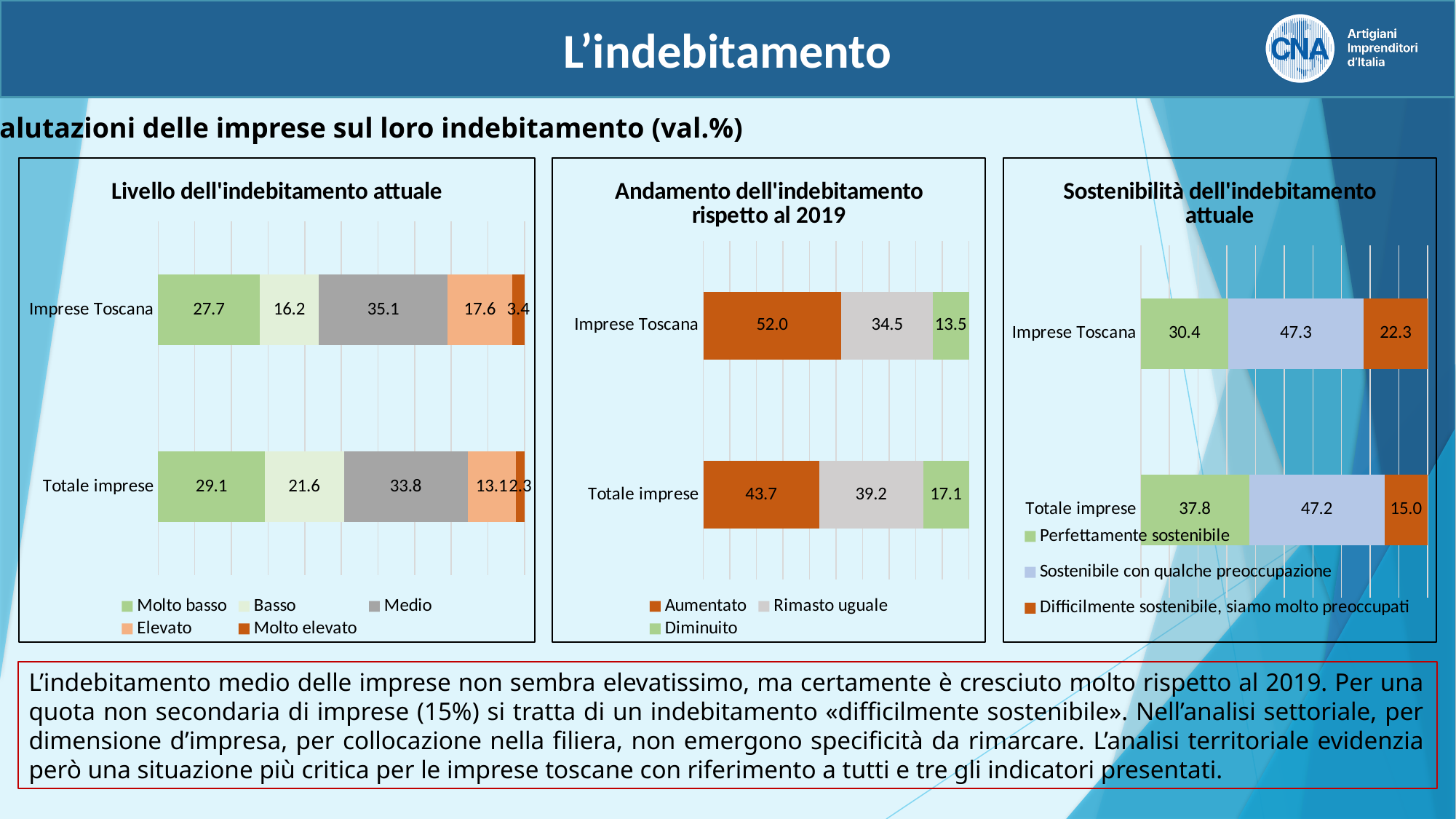
In the chart 'Andamento dell'indebitamento rispetto al 2019', what is the value of 'Aumentato' for Imprese Toscana? 52.0 In the chart 'Andamento dell'indebitamento rispetto al 2019', what is the difference between 'Aumentato' for Imprese Toscana and for Totale imprese? 8.3 What type of chart is 'Sostenibilità dell'indebitamento attuale'? Stacked bar chart In the chart 'Livello dell'indebitamento attuale', how many series does the legend list? 5 In the chart 'Andamento dell'indebitamento rispetto al 2019', what is the total of the stacked bar for Imprese Toscana? 100.0 How many charts are shown on the slide? 3 In the chart 'Livello dell'indebitamento attuale', which series has the largest value for Imprese Toscana? Medio In the chart 'Livello dell'indebitamento attuale', what is the value of 'Basso' for Totale imprese? 21.6 In the chart 'Andamento dell'indebitamento rispetto al 2019', which series has the smallest value for Totale imprese? Diminuito In the chart 'Livello dell'indebitamento attuale', what is the value of 'Medio' for Imprese Toscana? 35.1 In the chart 'Sostenibilità dell'indebitamento attuale', which is larger: 'Perfettamente sostenibile' for Imprese Toscana or for Totale imprese? Totale imprese In the chart 'Sostenibilità dell'indebitamento attuale', what is the value of 'Difficilmente sostenibile, siamo molto preoccupati' for Totale imprese? 15.0